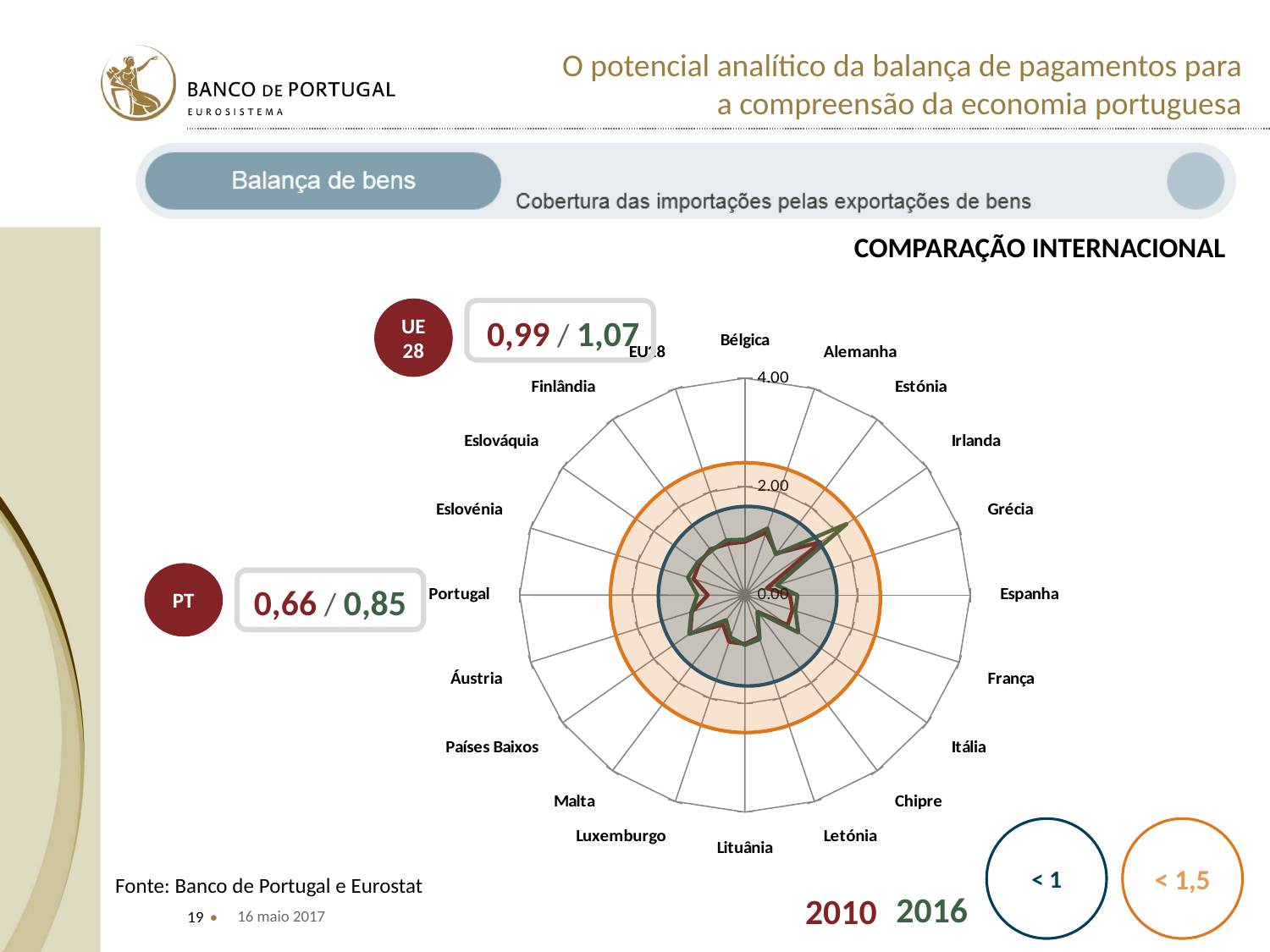
What is the value for Portugal (PT) in 2010? 0,66 What is the value for UE 28 in 2016? 1,07 What is the value for Portugal (PT) in 2016? 0,85 Which country has the highest value in 2016 on the radar chart? Irlanda Which colour is used for the 2016 series on the radar chart? green What kind of chart is shown on the slide? radar chart By how much did the value for Portugal (PT) change between 2010 and 2016? 0,19 Which is larger in 2016, the value for Portugal (PT) or the value for UE 28? UE 28 How many series does the legend of the radar chart list? 2 Is the value for Alemanha in 2016 greater or less than 2.00? less What is the value for UE 28 in 2010? 0,99 By how much did the value for UE 28 change between 2010 and 2016? 0,08